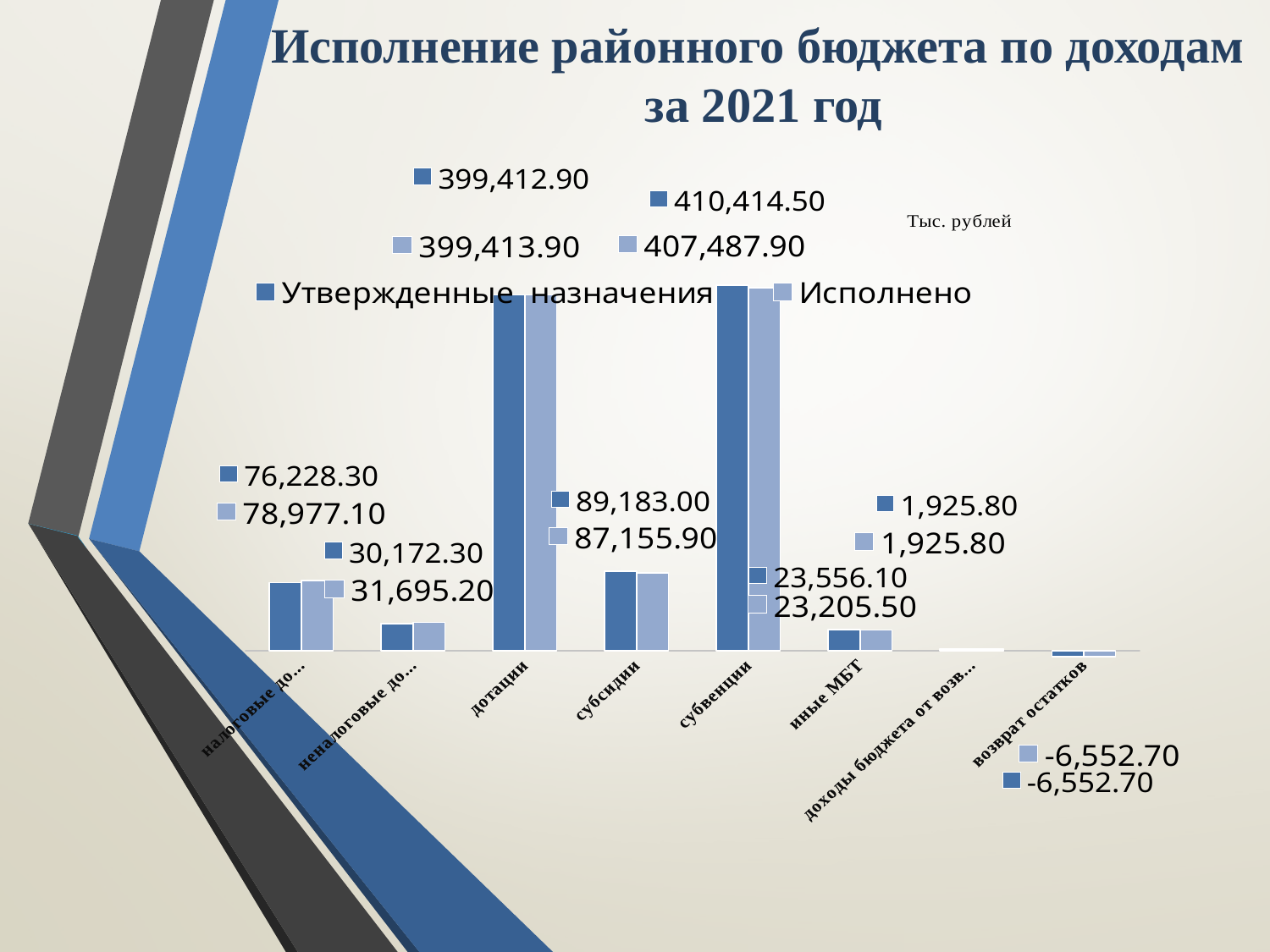
Which is larger for неналоговые доходы: Утвержденные назначения or Исполнено? Исполнено Which category has the highest value for Утвержденные назначения? субвенции What is the value of Утвержденные назначения for субвенции? 410,414.50 What is the value of Утвержденные назначения for иные МБТ? 23,556.10 What is the value of Исполнено for субсидии? 87,155.90 How many categories are shown on the x axis? 8 What are the two series named in the legend? Утвержденные назначения and Исполнено What is the value of Исполнено for дотации? 399,413.90 What kind of chart is shown on the slide? bar chart How many series does the legend list? 2 Which category has the lowest value for Исполнено? возврат остатков What is the difference between Утвержденные назначения and Исполнено for субсидии? 2,027.10